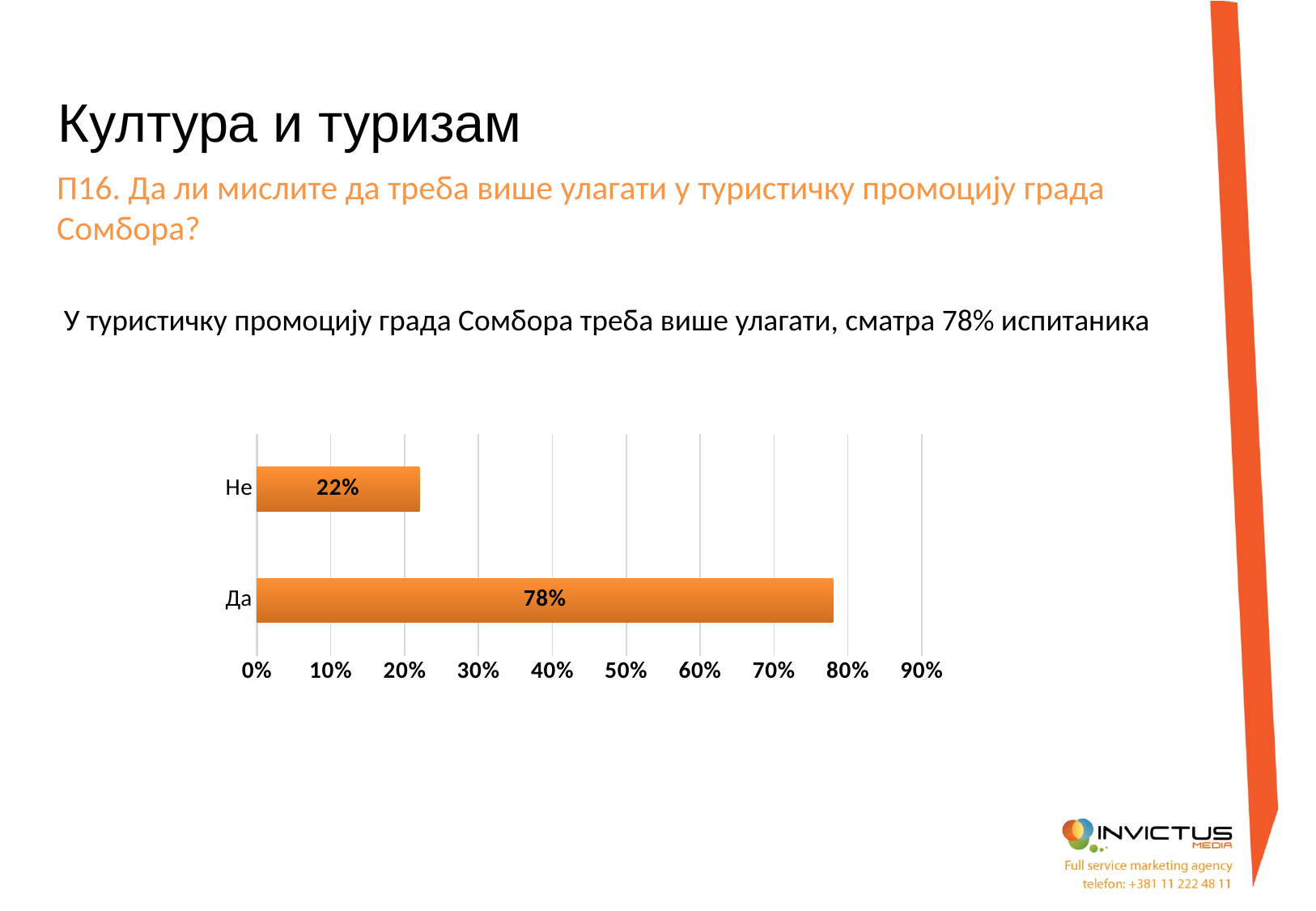
Which category has the highest value? Да Which category has the lowest value? Не Is the value for Не greater or less than 30%? less What is the value for Да? 78% What is the value for Не? 22% What is the highest value shown on the x axis? 90% What is the total of the two values shown in the chart? 100% Is the value for Да greater or less than 70%? greater What is the difference between the values for Да and Не? 56% What kind of chart is shown on the slide? bar chart Which is larger, the value for Да or the value for Не? Да How many categories are shown in the chart? 2